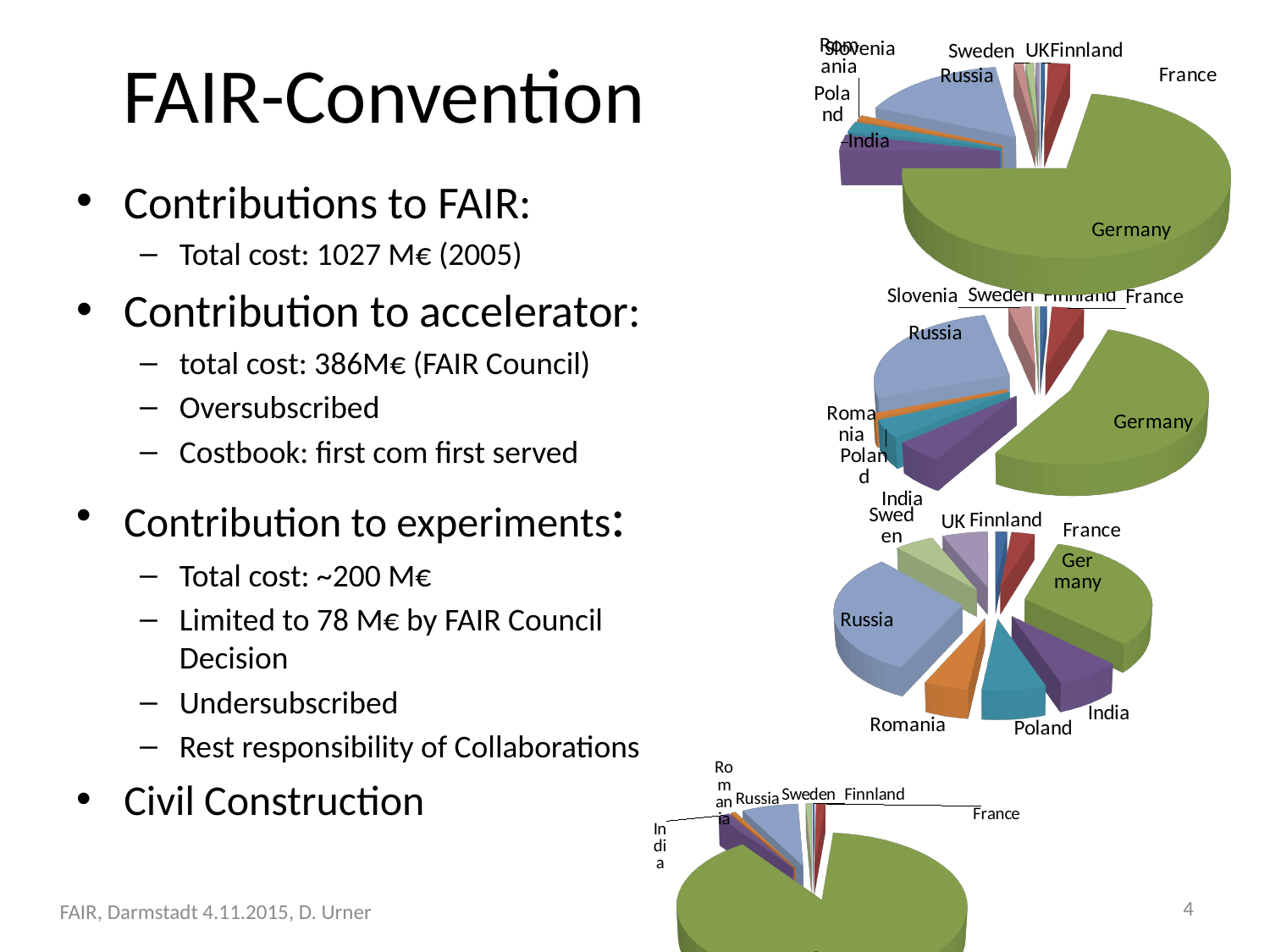
In the top-right pie chart, which slice is larger, Germany or Russia? Germany In the third pie chart from the top, which slice is larger, Russia or Poland? Russia How many country slices are labelled in the third pie chart from the top? 9 How many pie charts are shown on the slide? 4 In the second pie chart from the top, which country has the largest slice? Germany In the third pie chart from the top, which slice is larger, Germany or Finnland? Germany What colour is the Germany slice in the pie charts? green What kind of chart is the top-right chart on the slide? pie chart In the top-right pie chart, which country has the largest slice? Germany In the bottom pie chart, which country has the largest slice? Germany